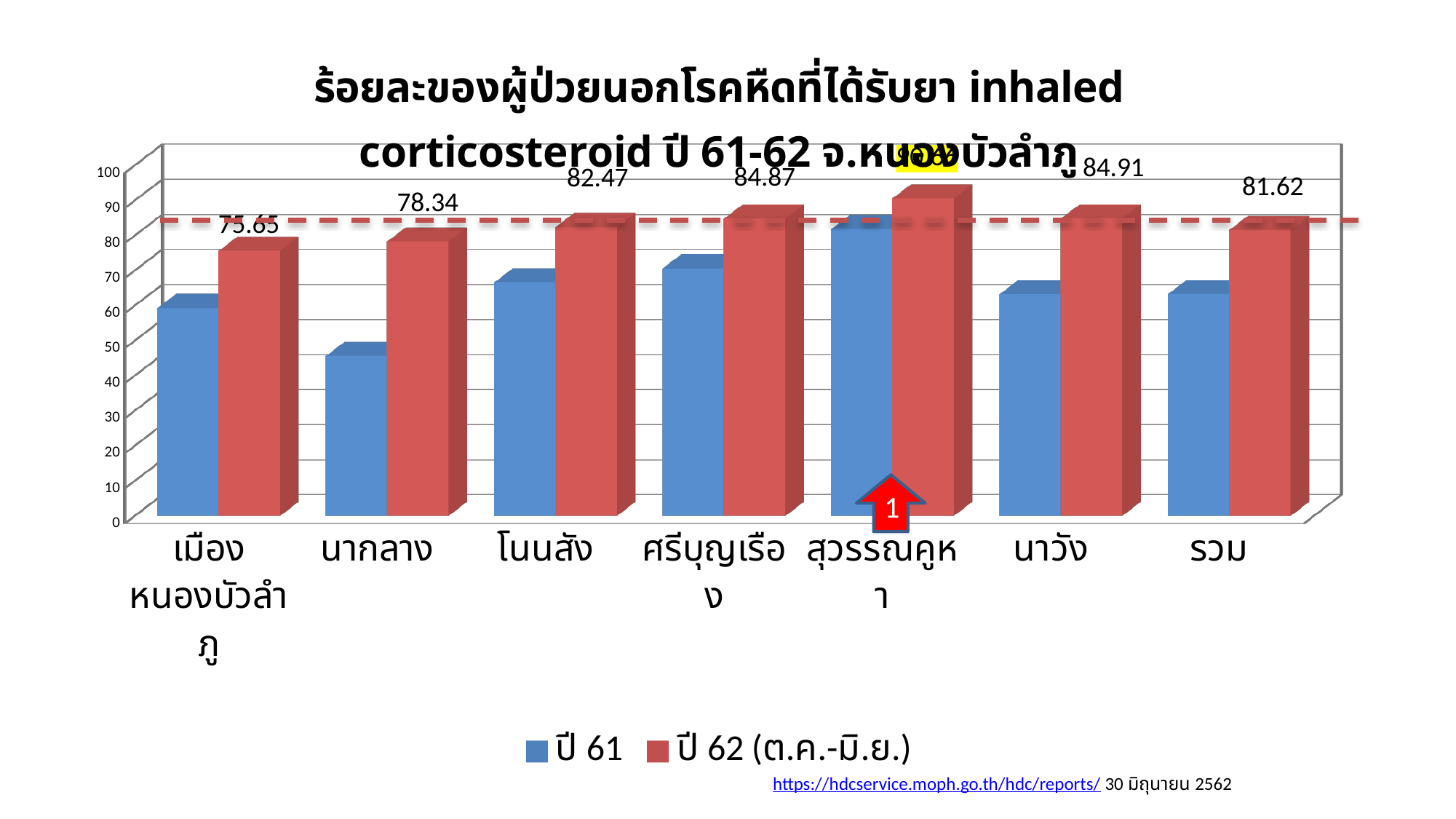
What is the difference between the ปี 62 (ต.ค.-มิ.ย.) values for โนนสัง and นากลาง? 4.13 What is the ปี 62 (ต.ค.-มิ.ย.) value for นาวัง? 84.91 What kind of chart is shown on the slide? bar chart What is the ปี 62 (ต.ค.-มิ.ย.) value for นากลาง? 78.34 What is the ปี 62 (ต.ค.-มิ.ย.) value for โนนสัง? 82.47 Which has the larger ปี 62 (ต.ค.-มิ.ย.) value, นากลาง or ศรีบุญเรือง? ศรีบุญเรือง How many categories are shown on the x axis? 7 What is the ปี 62 (ต.ค.-มิ.ย.) value for เมืองหนองบัวลำภู? 75.65 Is the ปี 61 value for เมืองหนองบัวลำภู greater or less than 50? greater Which category has the lowest ปี 62 (ต.ค.-มิ.ย.) value? เมืองหนองบัวลำภู What is the ปี 62 (ต.ค.-มิ.ย.) value for รวม? 81.62 How many series does the legend list? 2